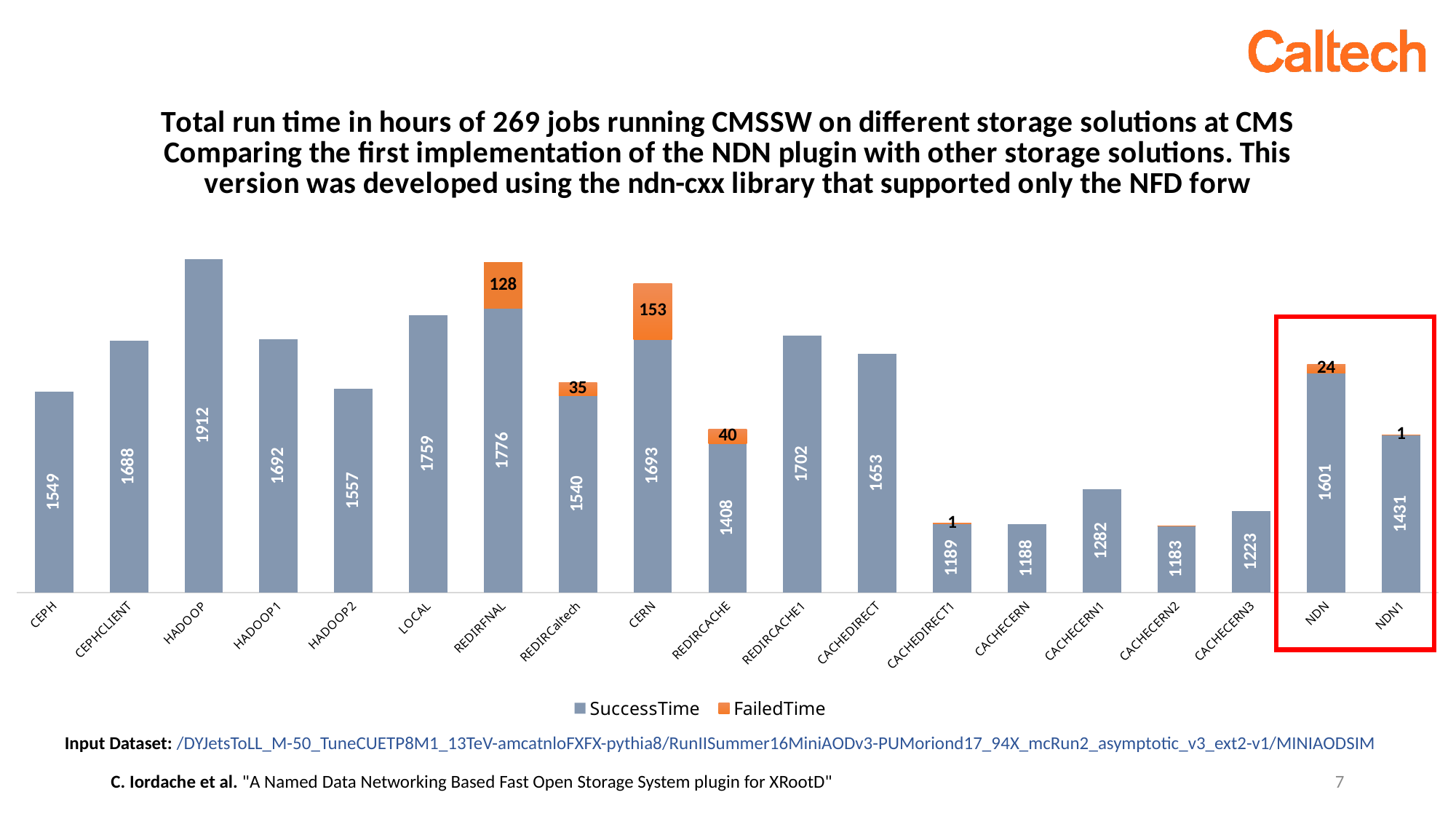
What is the total run time (SuccessTime plus FailedTime) for REDIRFNAL? 1904 What is the FailedTime value for CERN? 153 What is the SuccessTime value for REDIRCACHE? 1408 What is the difference in SuccessTime between NDN and NDN1? 170 What is the SuccessTime value for NDN? 1601 Which storage solution has the lowest SuccessTime? CACHECERN2 How many series does the legend list? 2 Which has the larger SuccessTime, CEPHCLIENT or HADOOP1? HADOOP1 Which storage solution has the largest FailedTime? CERN What kind of chart is shown on the slide? Stacked bar chart How many storage solutions (categories) are shown on the x axis? 19 Which storage solution has the highest SuccessTime? HADOOP